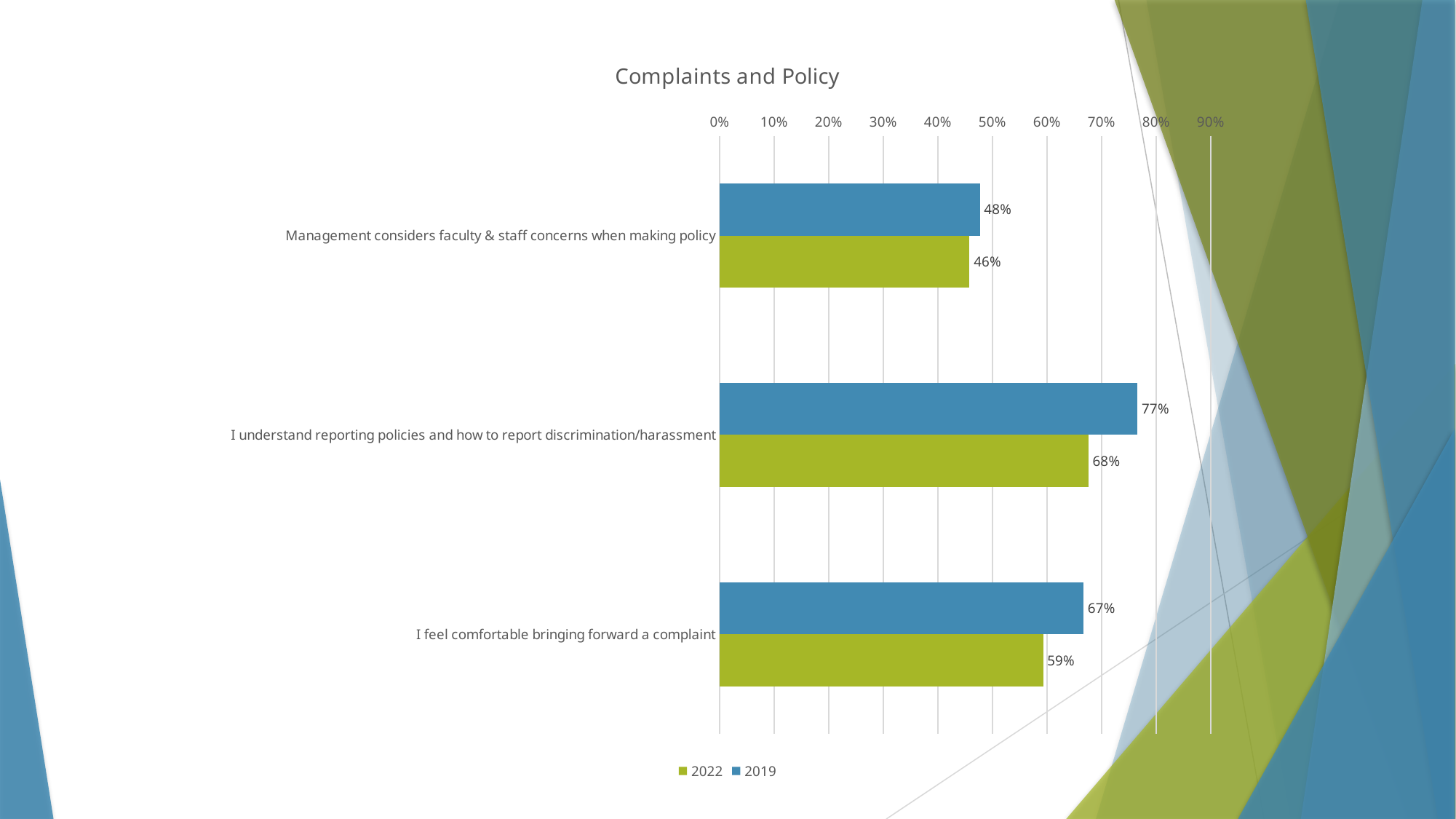
What is the 2022 value for "I feel comfortable bringing forward a complaint"? 59% How many series does the legend list? 2 Which is larger for "Management considers faculty & staff concerns when making policy": the 2019 value or the 2022 value? 2019 What is the 2019 value for "I understand reporting policies and how to report discrimination/harassment"? 77% Which category has the highest 2019 value? I understand reporting policies and how to report discrimination/harassment What is the 2022 value for "Management considers faculty & staff concerns when making policy"? 46% Is the 2019 value for "I feel comfortable bringing forward a complaint" greater or less than 60%? greater How many categories are shown in the chart? 3 Which category has the lowest 2022 value? Management considers faculty & staff concerns when making policy What is the difference between the 2019 and 2022 values for "I understand reporting policies and how to report discrimination/harassment"? 9% What is the difference between the 2019 and 2022 values for "I feel comfortable bringing forward a complaint"? 8% What type of chart is shown on the slide? Bar chart